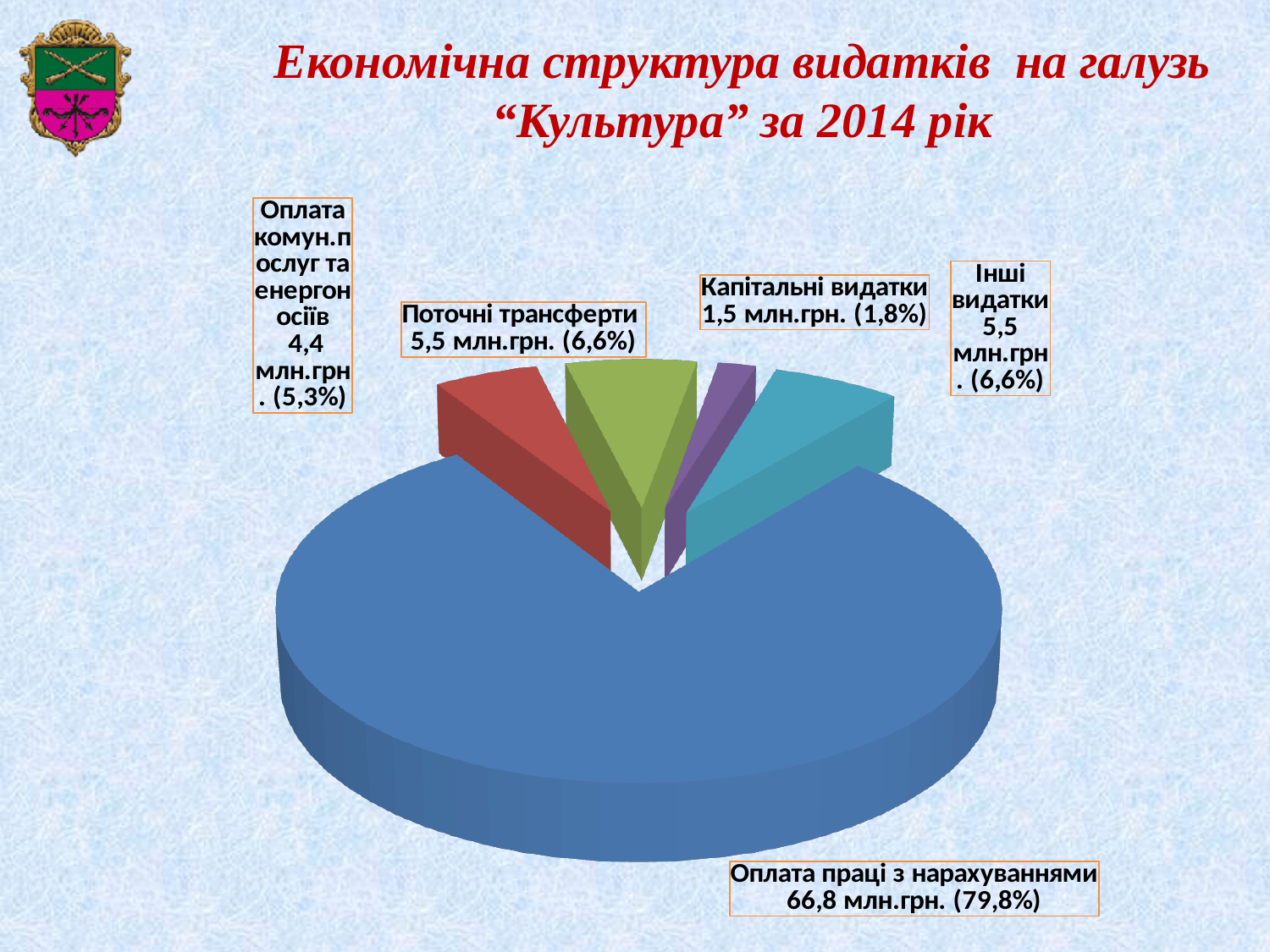
What share of the pie does Оплата праці з нарахуваннями represent? 79,8% What is the difference between Оплата праці з нарахуваннями and Поточні трансферти? 61,3 млн.грн. What share of the pie does Інші видатки represent? 6,6% What is the value for Оплата праці з нарахуваннями? 66,8 млн.грн. How many slices does the pie chart have? 5 Which category has the largest share of the pie? Оплата праці з нарахуваннями Which is larger: Оплата комун.послуг та енергоносіїв or Капітальні видатки? Оплата комун.послуг та енергоносіїв What is the value for Поточні трансферти? 5,5 млн.грн. Which category has the smallest share of the pie? Капітальні видатки What kind of chart is shown on the slide? Pie chart What is the value for Капітальні видатки? 1,5 млн.грн. What is the value for Оплата комун.послуг та енергоносіїв? 4,4 млн.грн.